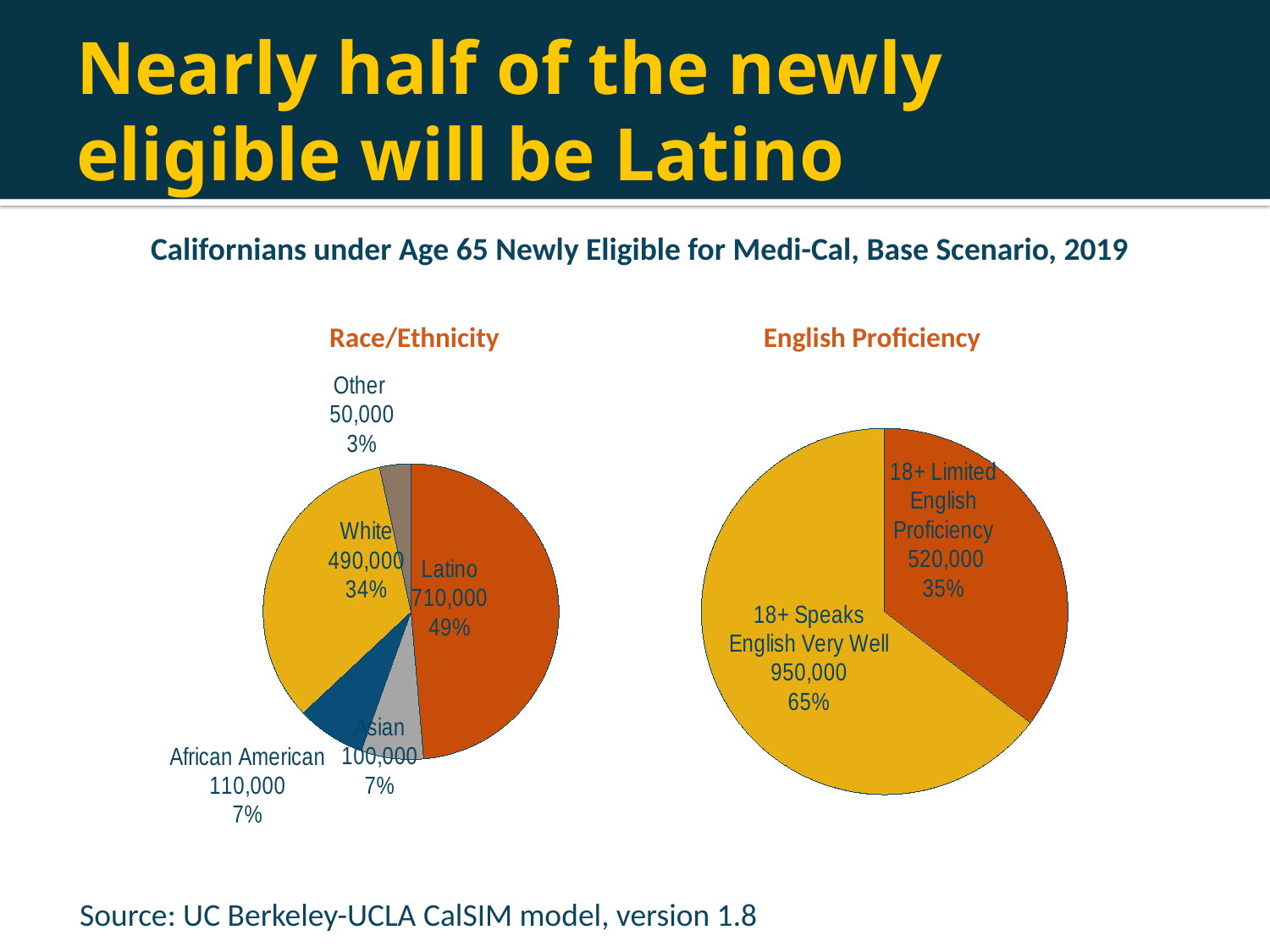
In the English Proficiency pie chart, what is the value for 18+ Speaks English Very Well? 950,000 In the English Proficiency pie chart, what share of the pie is 18+ Limited English Proficiency? 35% In the Race/Ethnicity pie chart, which is larger, African American or Asian? African American In the Race/Ethnicity pie chart, which category has the largest slice? Latino What kind of chart is the English Proficiency chart? Pie chart What is the title shown above the two charts? Californians under Age 65 Newly Eligible for Medi-Cal, Base Scenario, 2019 In the Race/Ethnicity pie chart, what is the value for Latino? 710,000 In the Race/Ethnicity pie chart, what is the difference between the Latino and White values? 220,000 In the Race/Ethnicity pie chart, which category has the smallest slice? Other How many categories does the Race/Ethnicity pie chart show? 5 In the English Proficiency pie chart, what is the difference between the two categories' values? 430,000 In the Race/Ethnicity pie chart, what share of the pie is White? 34%